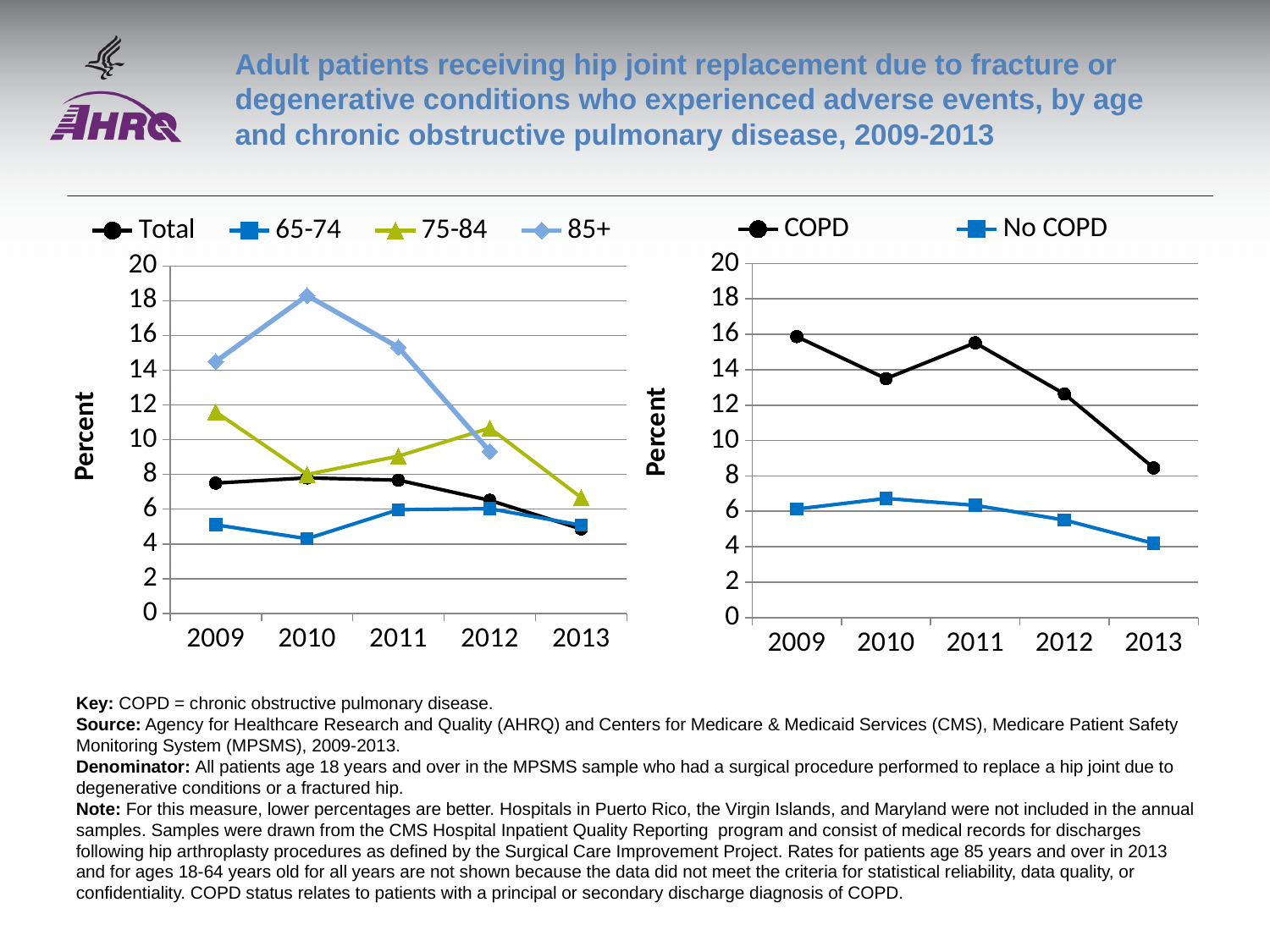
In the right chart, in which year is the COPD series at its lowest? 2013 In the right chart, which is larger in 2009, COPD or No COPD? COPD In the left chart, in which year is the 85+ series at its highest? 2010 In the right chart, does the No COPD series rise or fall from 2011 to 2013? fall What kind of chart is the left chart (with the age-group series)? line chart In the left chart, is the value for 75-84 in 2009 greater or less than 10? greater How many series does the legend of the left chart list? 4 In the left chart, is the value for 85+ in 2010 greater or less than 16? greater What is the y-axis label on the right chart? Percent In the right chart, is the value for COPD in 2013 greater or less than 10? less How many series does the legend of the right chart (COPD / No COPD) list? 2 How many years are shown on the x axis of the left chart? 5